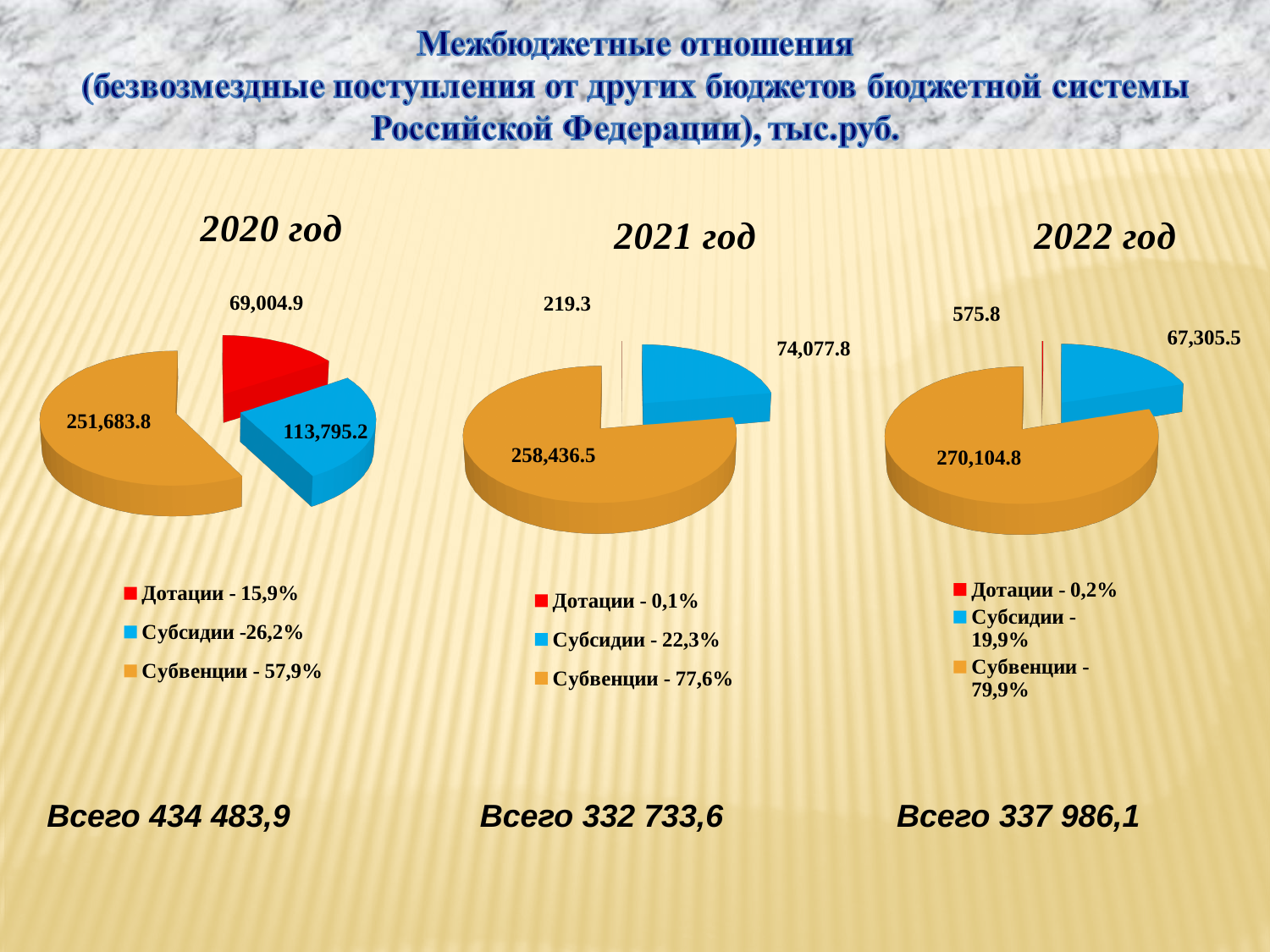
In the 2022 год pie chart, what is the value for Субвенции? 270,104.8 In the 2022 год pie chart, what is the difference between the values for Субвенции and Субсидии? 202,799.3 In the 2020 год pie chart, what is the value for Субсидии? 113,795.2 In the 2020 год pie chart, what is the difference between the values for Субвенции and Субсидии? 137,888.6 According to the legend, what share of the 2022 год pie does Субсидии represent? 19,9% How many categories does the 2020 год pie chart show? 3 In the 2022 год pie chart, which category has the smallest value? Дотации In the 2021 год pie chart, which is larger: Субсидии or Дотации? Субсидии In the 2020 год pie chart, which category has the largest value? Субвенции According to the legend, what share of the 2021 год pie does Субвенции represent? 77,6% In the 2021 год pie chart, what is the value for Дотации? 219.3 What type of chart is used for the 2021 год data? Pie chart